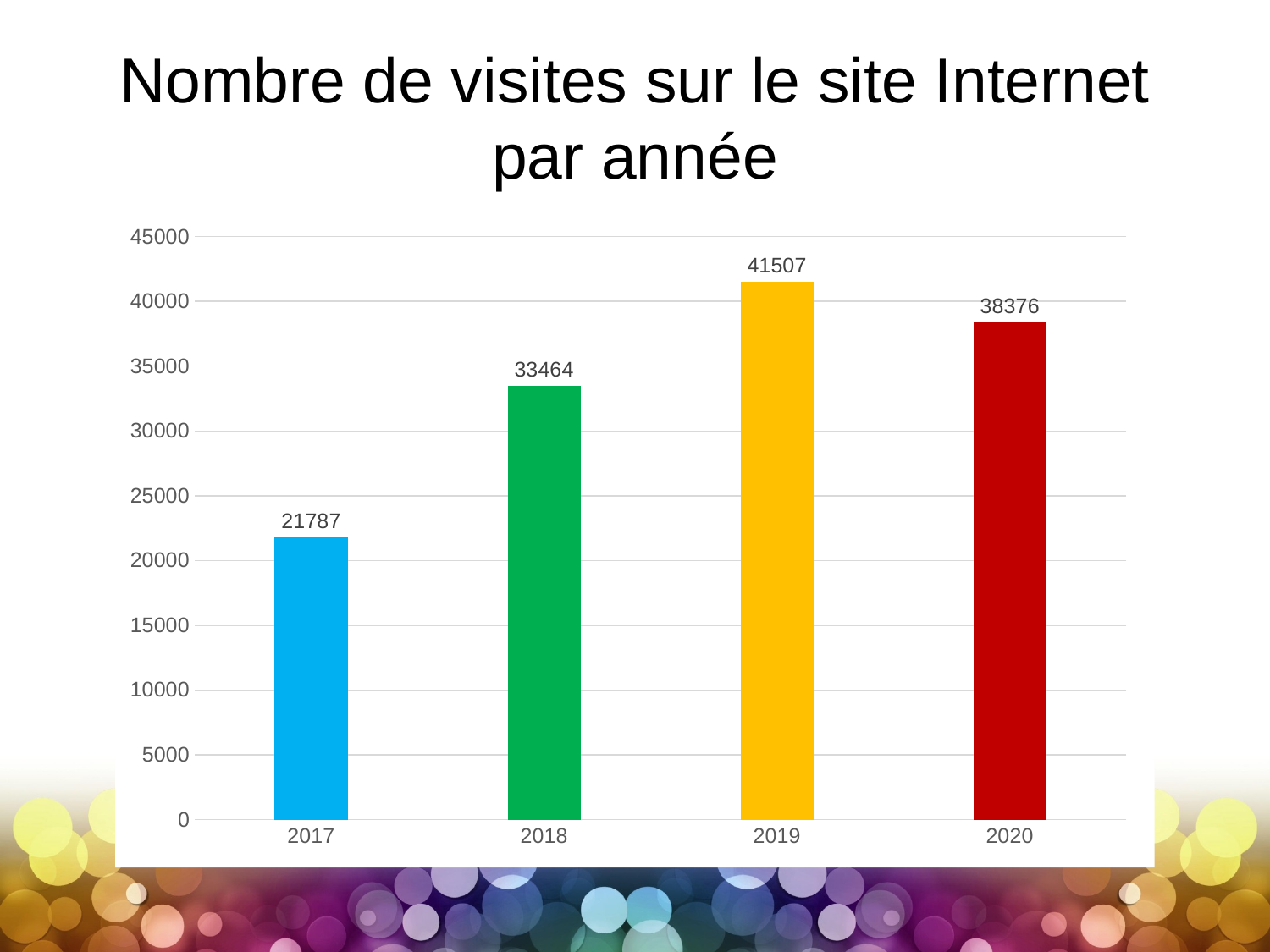
How many years are shown on the chart? 4 Is the value for 2018 greater or less than 30000? greater What kind of chart is shown on the slide? bar chart What is the number of visits for 2020? 38376 Which year has the highest number of visits? 2019 Which year has the lowest number of visits? 2017 What is the number of visits for 2017? 21787 What is the title of the chart? Nombre de visites sur le site Internet par année What is the difference in visits between 2018 and 2017? 11677 What is the difference in visits between 2019 and 2020? 3131 What is the number of visits for 2019? 41507 Which year has more visits, 2018 or 2020? 2020